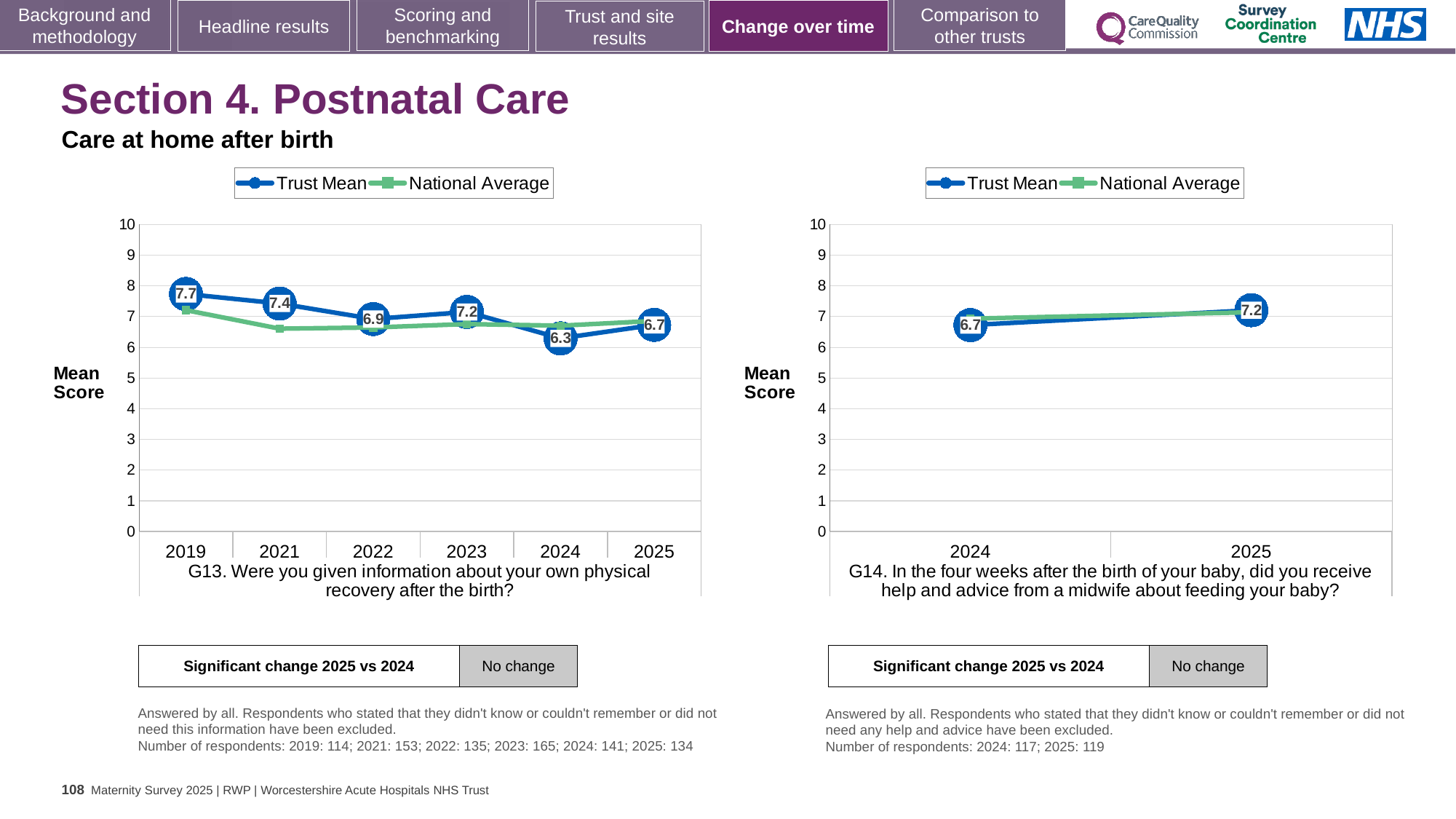
How many series does the legend of the G14 chart list? 2 In the G13 chart, which year has the lowest Trust Mean score? 2024 In the G13 chart, how many years are plotted on the x axis? 6 In the G13 chart, what is the difference between the Trust Mean scores for 2019 and 2024? 1.4 In the G13 chart, what is the Trust Mean score for 2019? 7.7 In the G14 chart, what is the difference between the Trust Mean scores for 2025 and 2024? 0.5 What type of chart is the G13 chart? Line chart In the G13 chart, is the Trust Mean score for 2022 greater or less than 7? less In the G13 chart, which year has the highest Trust Mean score? 2019 In the G14 chart, what is the Trust Mean score for 2025? 7.2 In the G14 chart, which year has the higher Trust Mean score, 2024 or 2025? 2025 In the G13 chart, what is the Trust Mean score for 2024? 6.3